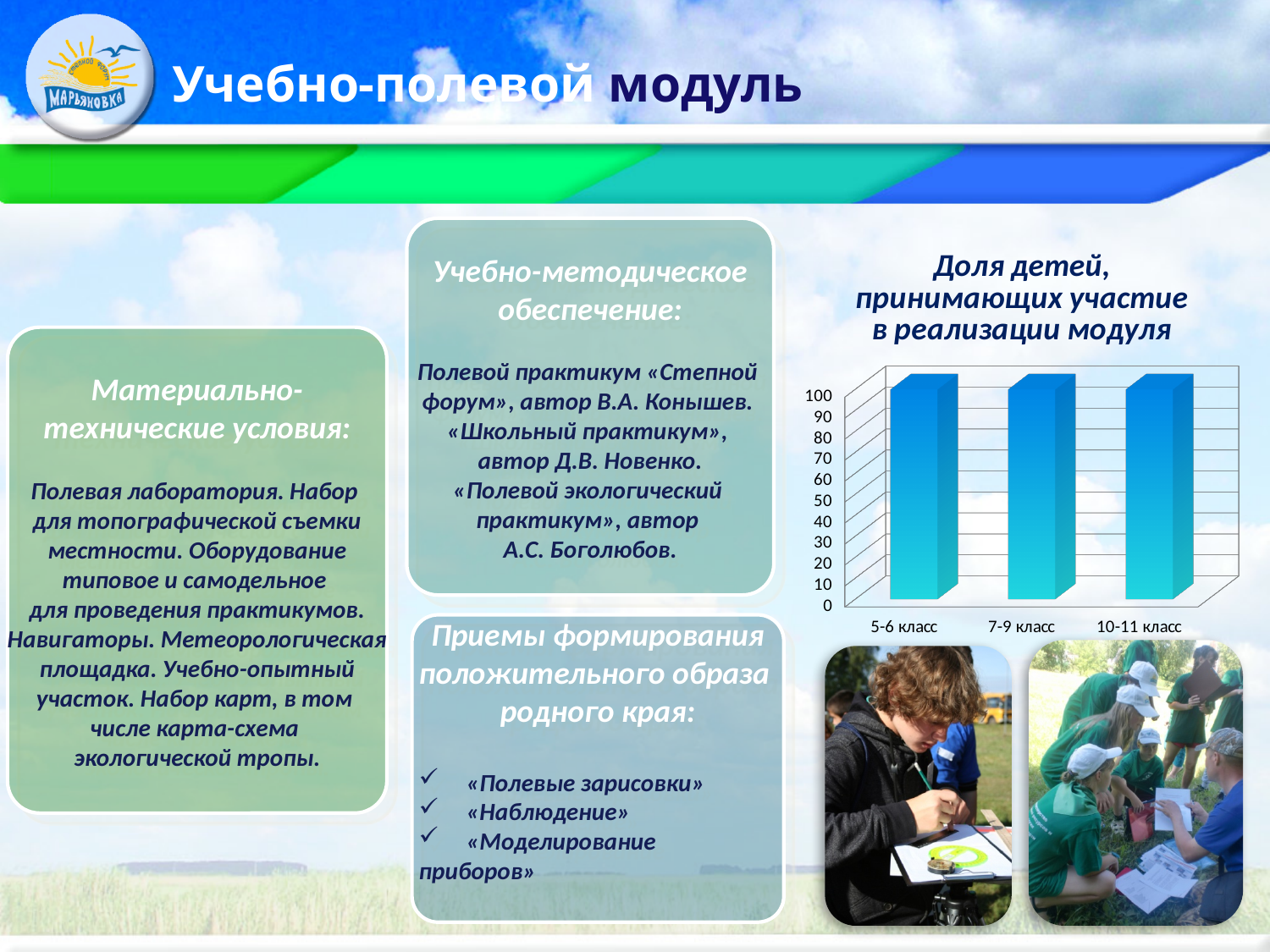
What is the highest tick value shown on the vertical axis of the chart? 100 What is the title of the chart? Доля детей, принимающих участие в реализации модуля How many categories are shown on the x axis of the chart? 3 Is the value for 5-6 класс greater or less than 50? greater Is the value for 7-9 класс greater or less than 90? greater Is the value for 5-6 класс greater or less than 90? greater Which category is listed first on the x axis of the chart? 5-6 класс Do the values rise, fall, or stay about the same across the categories from 5-6 класс to 10-11 класс? stay about the same What kind of chart is shown on the slide? bar chart